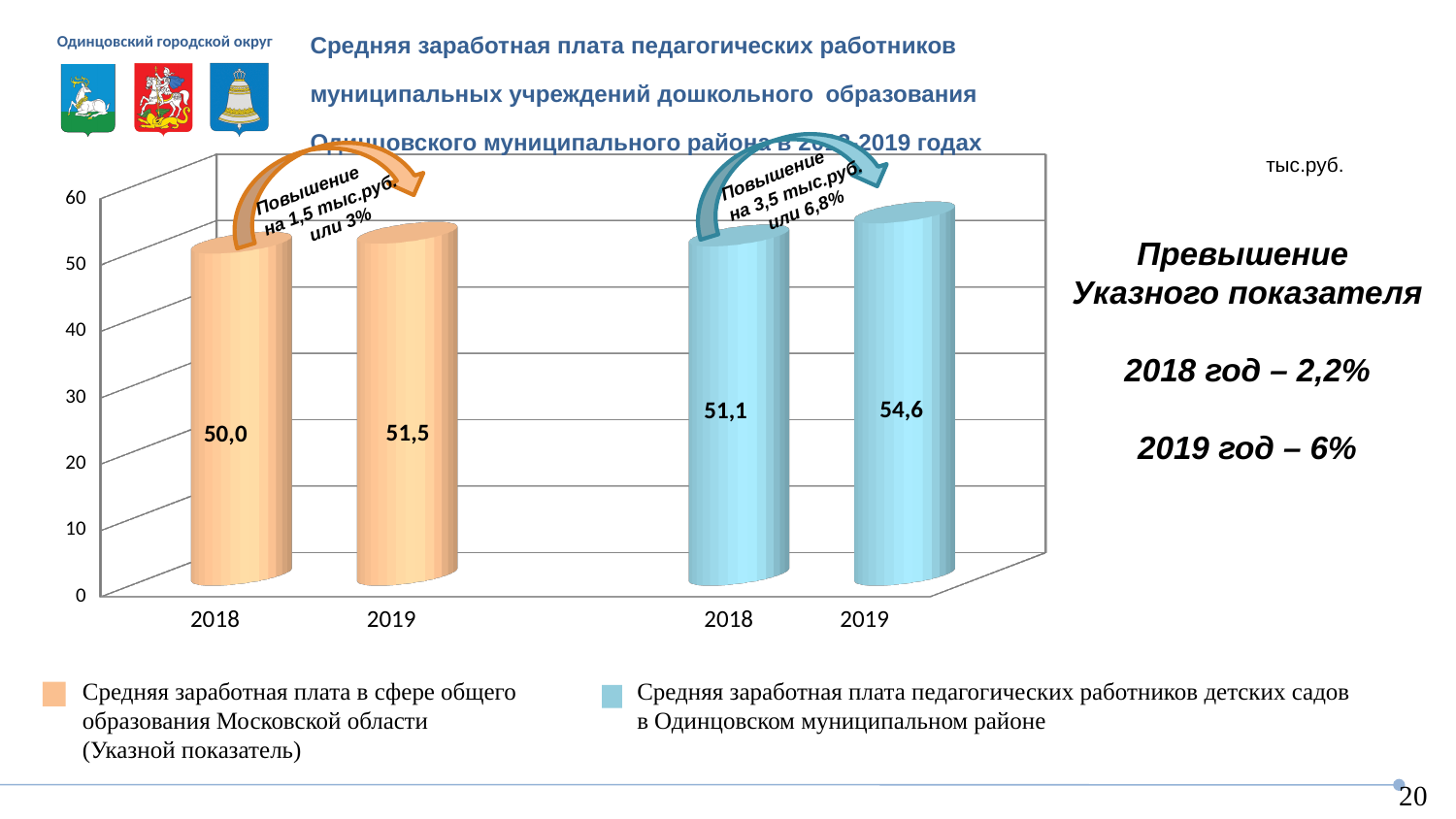
Which bar has the lowest value on the chart? 2018, Средняя заработная плата в сфере общего образования Московской области (50,0) How many series does the legend list? 2 What is the difference between the 2019 and 2018 values for the Moscow region general education series (orange bars)? 1,5 What is the value for 2018 for the series "Средняя заработная плата в сфере общего образования Московской области (Указной показатель)"? 50,0 What is the difference between the 2019 and 2018 values for the Odintsovo kindergarten teachers series (blue bars)? 3,5 Which is larger: the 2019 value for the Moscow region general education series or the 2019 value for the Odintsovo kindergarten teachers series? Odintsovo kindergarten teachers series (54,6) What is the value for 2019 for the series "Средняя заработная плата в сфере общего образования Московской области (Указной показатель)"? 51,5 Which bar has the highest value on the chart? 2019, Средняя заработная плата педагогических работников детских садов в Одинцовском муниципальном районе (54,6) What is the value for 2019 for the series "Средняя заработная плата педагогических работников детских садов в Одинцовском муниципальном районе"? 54,6 What type of chart is shown on the slide? bar chart What unit of measurement is indicated for the chart values? тыс.руб. What is the value for 2018 for the series "Средняя заработная плата педагогических работников детских садов в Одинцовском муниципальном районе"? 51,1